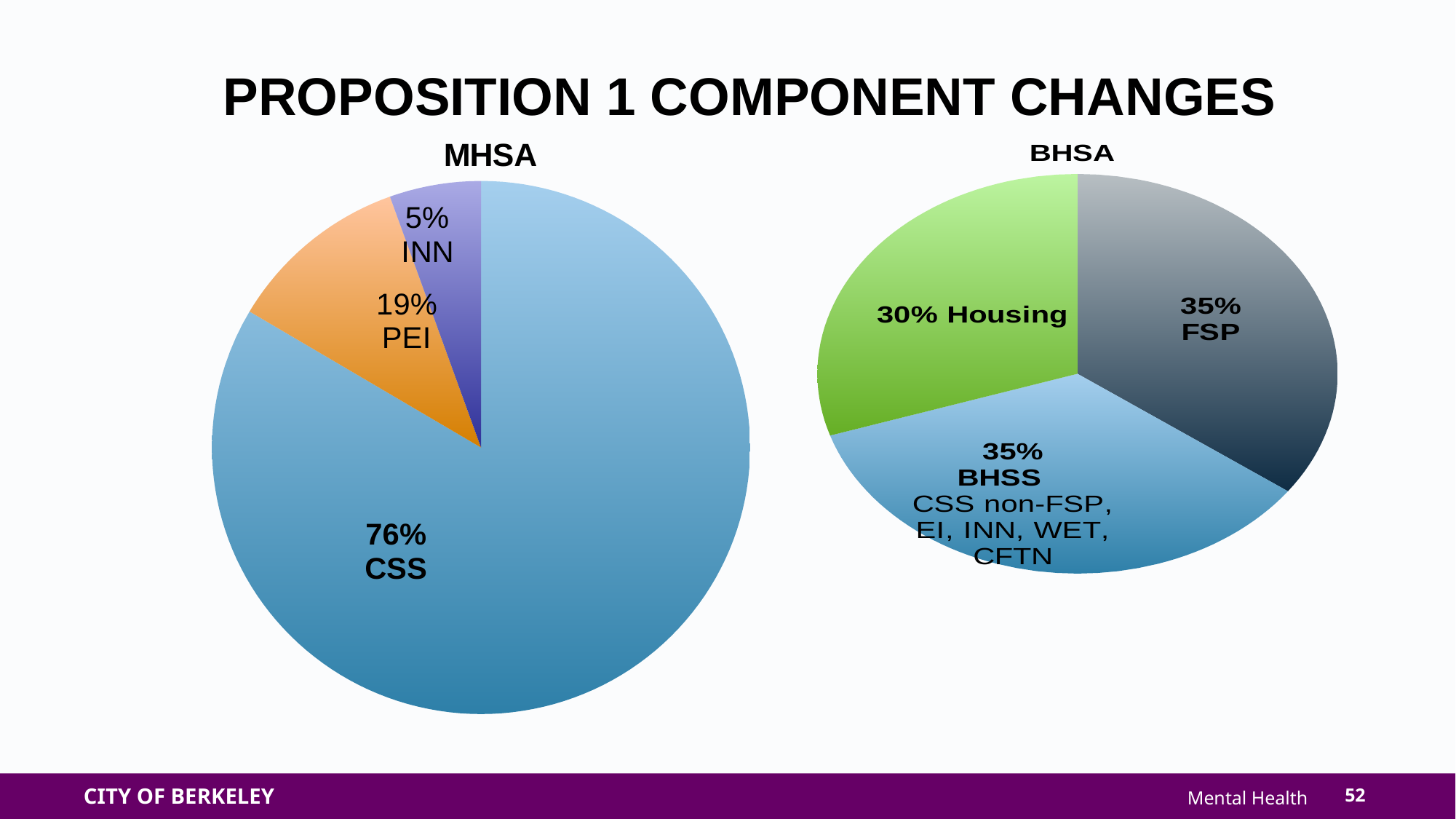
In the BHSA chart, what share does Housing have? 30% In the BHSA chart, which component has the smallest share? Housing In the BHSA chart, which is larger, the FSP share or the Housing share? FSP In the MHSA chart, which component has the largest share? CSS In the BHSA chart, what share does FSP have? 35% In the MHSA chart, what share does INN have? 5% In the MHSA chart, what is the difference between the CSS share and the PEI share? 57 percentage points In the MHSA chart, which component has the smallest share? INN In the MHSA chart, what share does PEI have? 19% In the MHSA chart, what share does CSS have? 76% What kind of chart is the MHSA chart? Pie chart How many slices does the BHSA chart have? 3